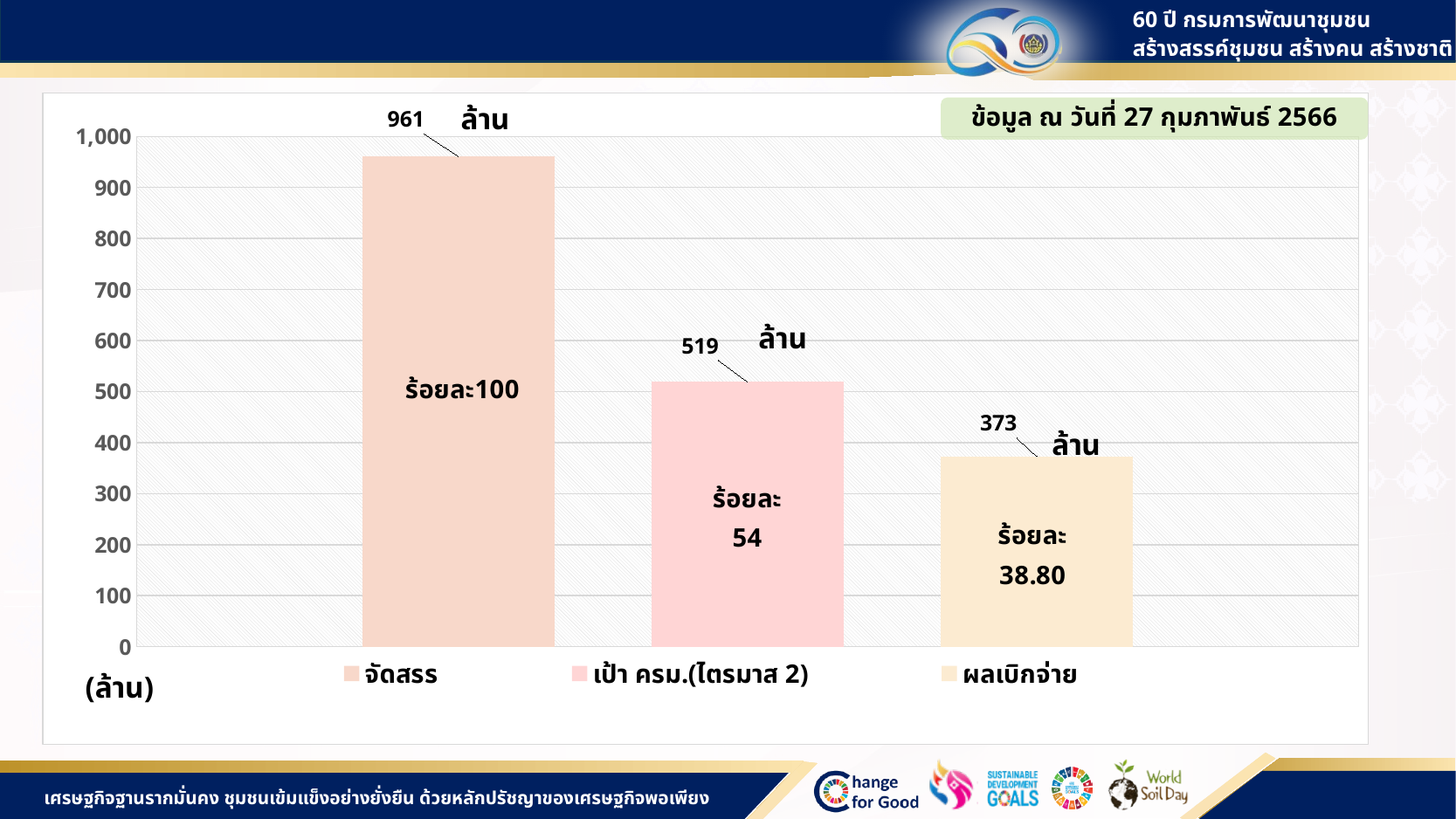
Which category has the lowest value? ผลเบิกจ่าย What kind of chart is shown on the slide? Bar chart What is the value shown for เป้า ครม.(ไตรมาส 2)? 519 ล้าน Which category has the highest value? จัดสรร What is the value shown for จัดสรร? 961 ล้าน What percentage is printed inside the เป้า ครม.(ไตรมาส 2) bar? ร้อยละ 54 Which is larger, the value for เป้า ครม.(ไตรมาส 2) or the value for ผลเบิกจ่าย? เป้า ครม.(ไตรมาส 2) What is the difference between the values for จัดสรร and ผลเบิกจ่าย? 588 What is the value shown for ผลเบิกจ่าย? 373 ล้าน How many bars are plotted in the chart? 3 What percentage is printed inside the ผลเบิกจ่าย bar? ร้อยละ 38.80 What date is the data on the slide stated to be as of? 27 กุมภาพันธ์ 2566